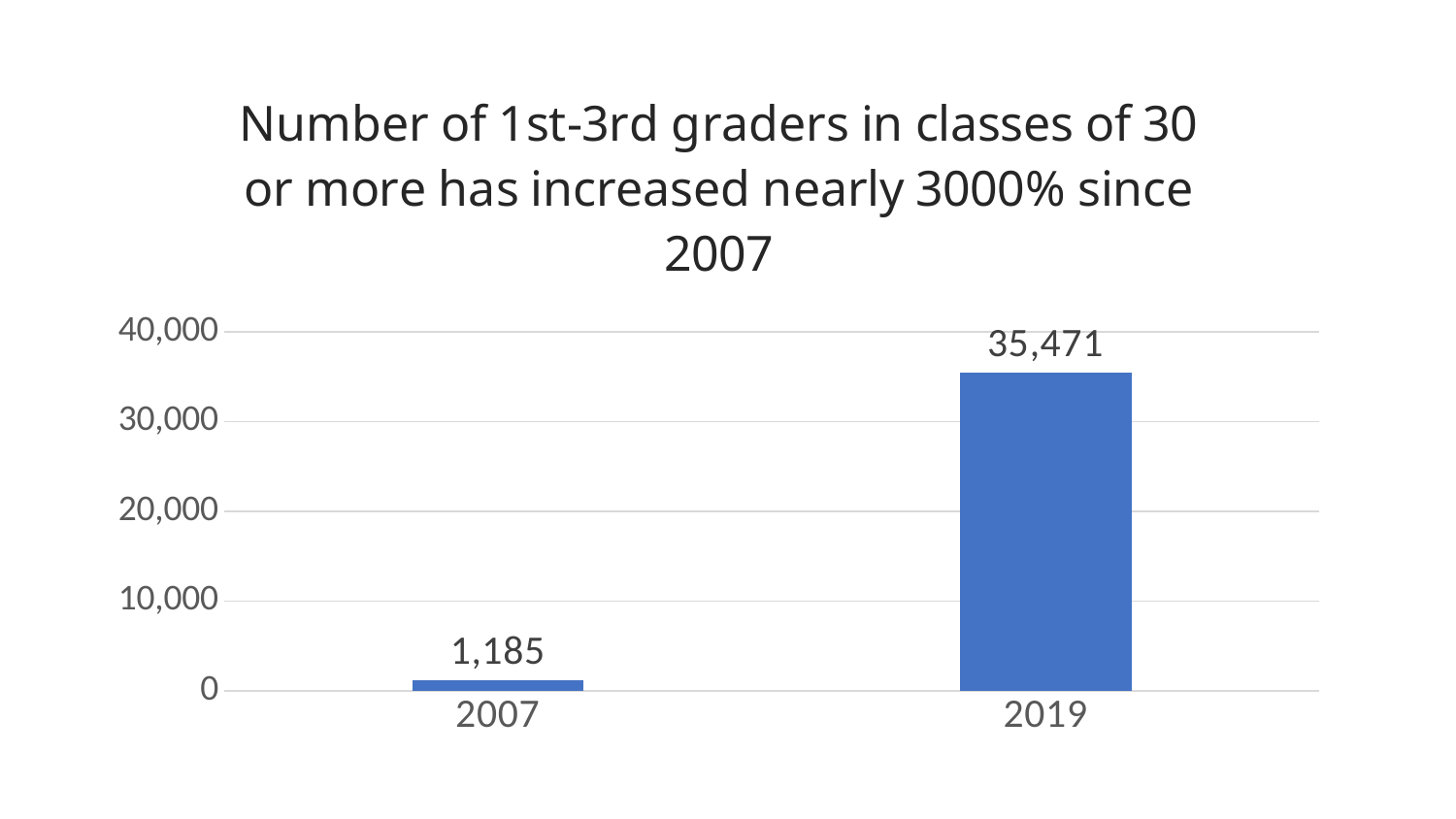
What is the title of the chart? Number of 1st-3rd graders in classes of 30 or more has increased nearly 3000% since 2007 Do the values rise or fall from 2007 to 2019? rise What is the value for 2007? 1,185 Which year has the lowest value? 2007 What is the value for 2019? 35,471 What kind of chart is shown on the slide? bar chart How many categories are shown on the x axis? 2 Is the value for 2007 greater or less than 10,000? less Which year has the highest value? 2019 Is the value for 2019 greater or less than 30,000? greater What is the difference between the values for 2019 and 2007? 34,286 Which is larger, the value for 2007 or the value for 2019? 2019